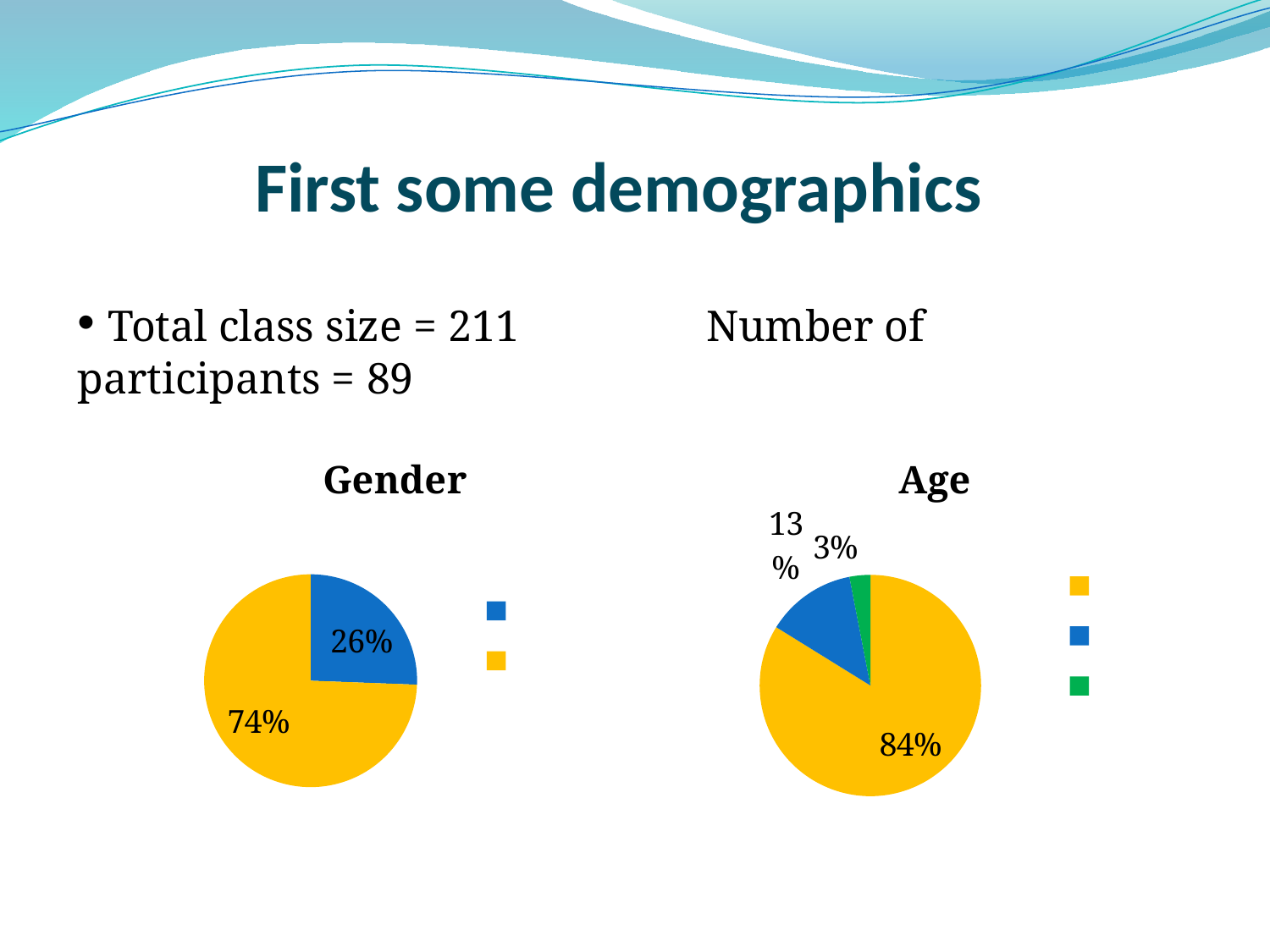
In the Gender chart, what percentage is shown on the yellow slice? 74% In the Age chart, how many slices does the pie have? 3 What are the titles of the two pie charts on the slide? Gender and Age In the Age chart, which colour slice is the smallest? green In the Age chart, what percentage is shown on the yellow slice? 84% In the Age chart, which is larger, the blue slice or the green slice? blue In the Gender chart, what percentage is shown on the blue slice? 26% In the Gender chart, how many slices does the pie have? 2 What kind of chart is the Gender chart? pie chart In the Age chart, which colour slice is the largest? yellow In the Age chart, what percentage is shown on the green slice? 3% In the Gender chart, what is the difference in percentage points between the yellow slice and the blue slice? 48